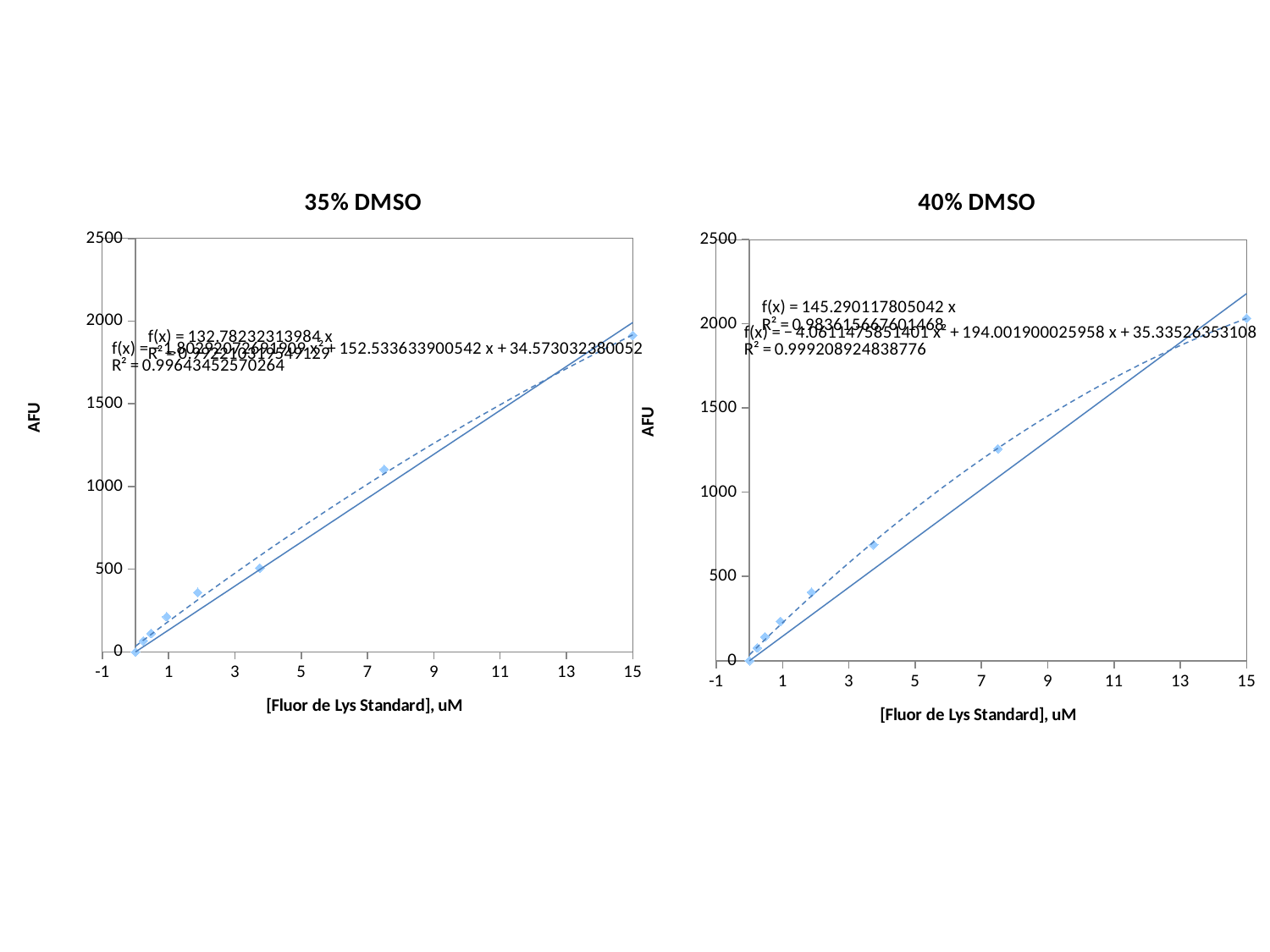
What kind of chart is the 35% DMSO chart? scatter chart What is the x-axis label of the 35% DMSO chart? [Fluor de Lys Standard], uM In the 35% DMSO chart, is the AFU value at 15 uM greater or less than 2000? less In the 40% DMSO chart, is the AFU value at about 3.75 uM greater or less than 500? greater In the 40% DMSO chart, do the AFU values rise or fall as the Fluor de Lys Standard concentration increases? rise In the 35% DMSO chart, is the AFU value at about 7.5 uM greater or less than 1000? greater In the 40% DMSO chart, what is the R² value shown for the linear fit f(x) = 145.290117805042 x? 0.983615667601468 Which chart shows the higher AFU value at 15 uM, 35% DMSO or 40% DMSO? 40% DMSO How many data points are plotted in the 40% DMSO chart? 8